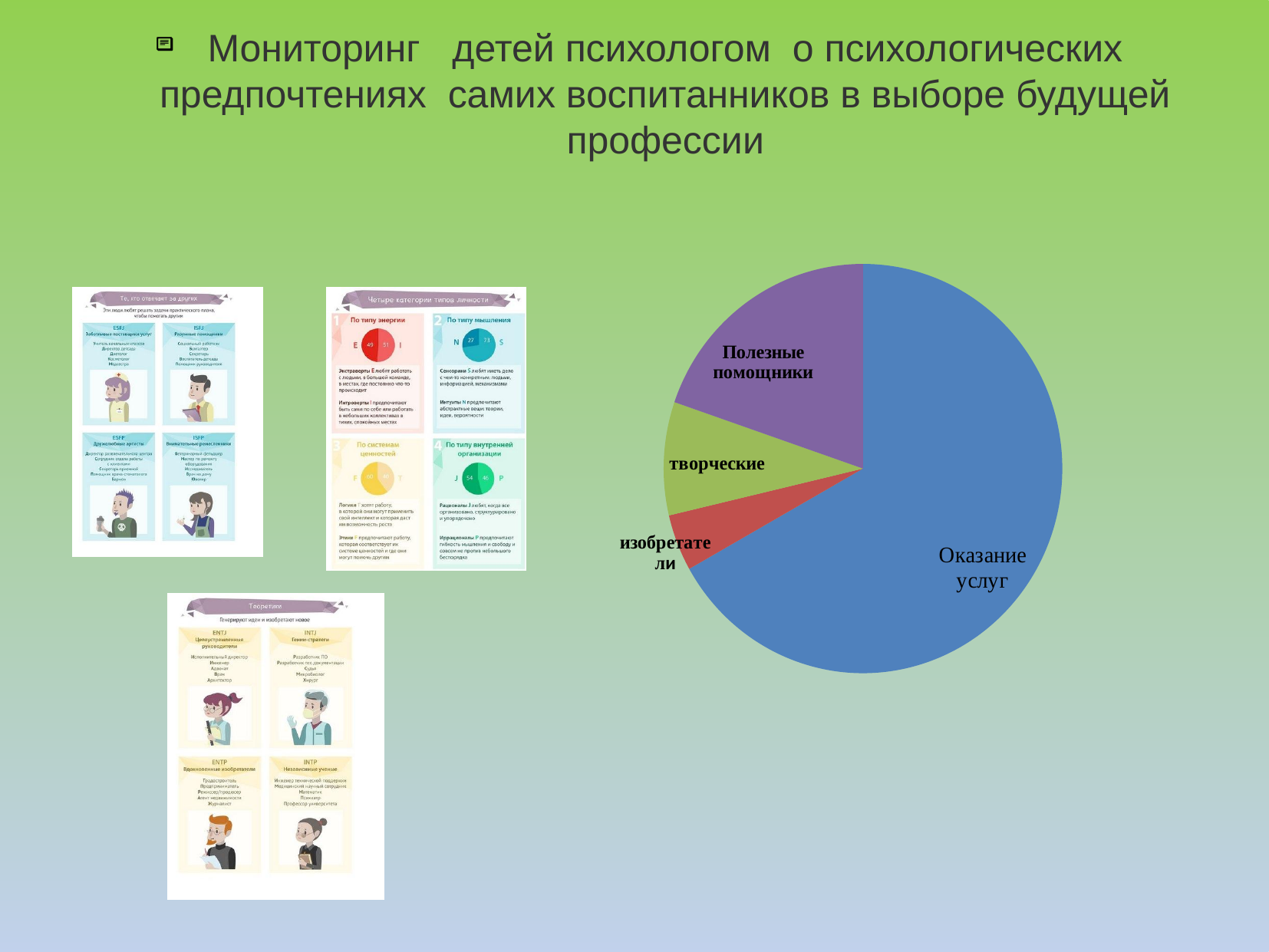
Which slice is larger in the pie chart, Полезные помощники or творческие? Полезные помощники What kind of chart is shown on the right side of the slide? pie chart What colour is the Полезные помощники slice in the pie chart? purple Which category has the largest slice in the pie chart? Оказание услуг Which slice is larger in the pie chart, Оказание услуг or Полезные помощники? Оказание услуг What colour is the Оказание услуг slice in the pie chart? blue Which category has the smallest slice in the pie chart? изобретатели Does the Оказание услуг slice take up more or less than half of the pie chart? more How many slices does the pie chart have? 4 Which slice is larger in the pie chart, творческие or изобретатели? творческие